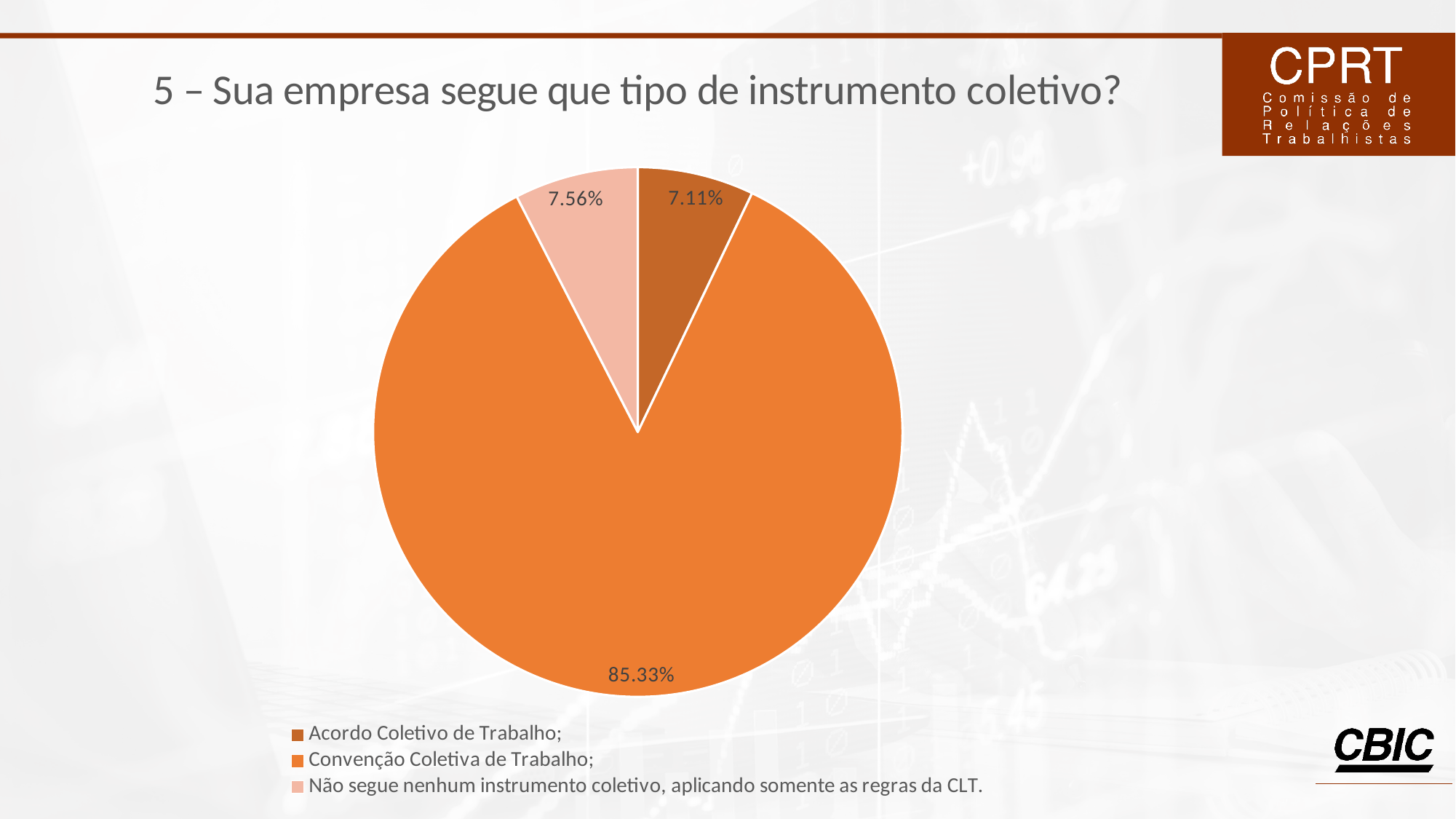
What percentage of companies do not follow any collective instrument, applying only the CLT rules? 7.56% How many slices does the pie chart have? 3 What is the difference in percentage points between Convenção Coletiva de Trabalho and Acordo Coletivo de Trabalho? 78.22 What percentage of companies follow an Acordo Coletivo de Trabalho? 7.11% What is the title of the chart on the slide? 5 – Sua empresa segue que tipo de instrumento coletivo? Which is larger: the share for Acordo Coletivo de Trabalho or the share for companies that follow no collective instrument? companies that follow no collective instrument (7.56%) What is the difference in percentage points between the 'Não segue nenhum instrumento coletivo' slice and the Acordo Coletivo de Trabalho slice? 0.45 Which category has the smallest share of the pie? Acordo Coletivo de Trabalho Which category has the largest share of the pie? Convenção Coletiva de Trabalho How many entries does the legend list? 3 What percentage of companies follow a Convenção Coletiva de Trabalho? 85.33% What type of chart is shown on the slide? pie chart